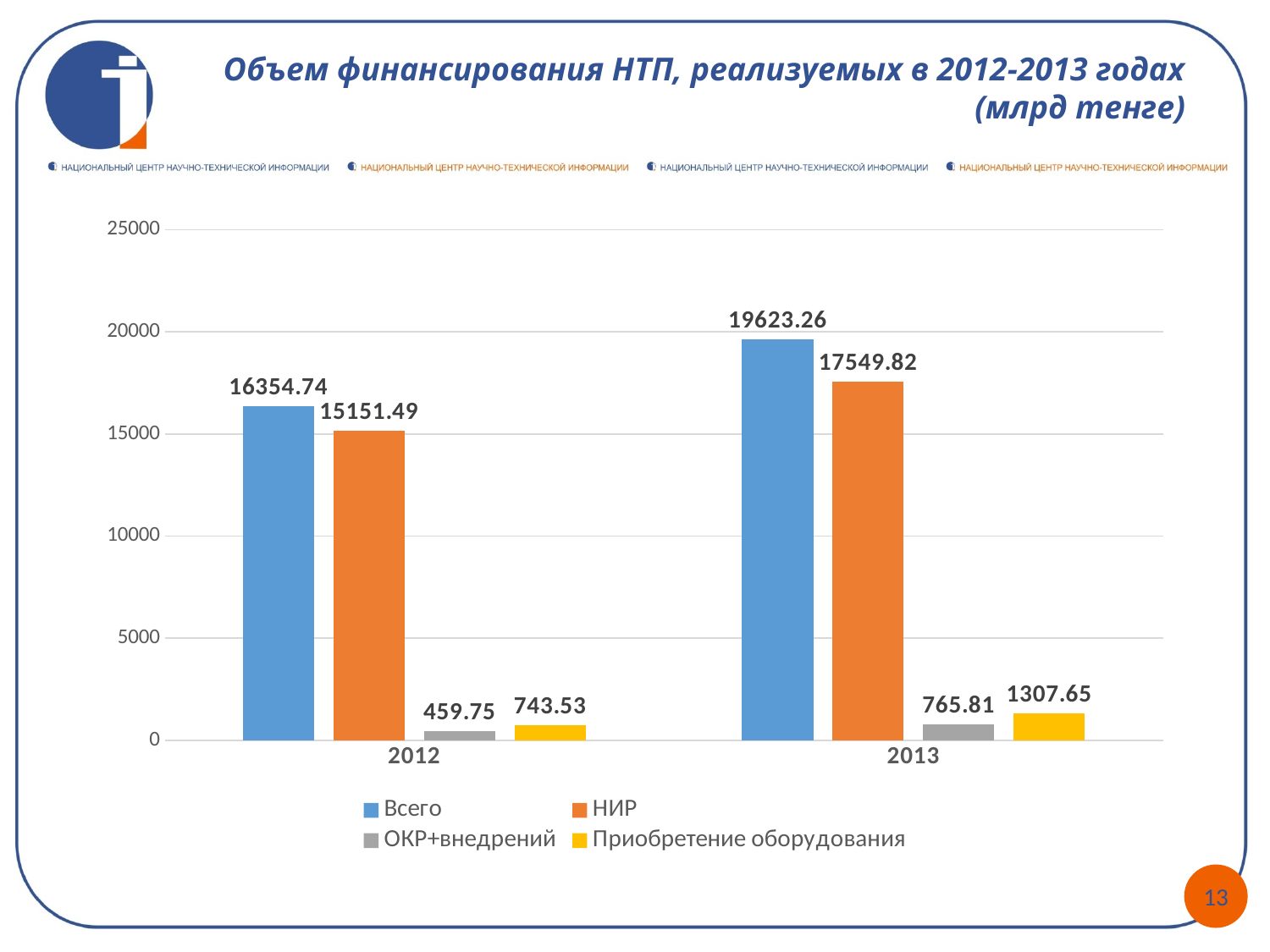
Is the value for НИР in 2012 greater or less than 15000? greater What is the difference between the Приобретение оборудования values for 2013 and 2012? 564.12 Which series has the lowest value in 2013? ОКР+внедрений Does the value for НИР rise or fall from 2012 to 2013? rise How many series does the legend list? 4 What is the value for ОКР+внедрений in 2012? 459.75 What is the value for Приобретение оборудования in 2013? 1307.65 What kind of chart is shown on the slide? bar chart Which year has the higher value for Всего? 2013 What is the difference between the Всего values for 2013 and 2012? 3268.52 What is the value for Всего in 2012? 16354.74 What is the value for НИР in 2013? 17549.82